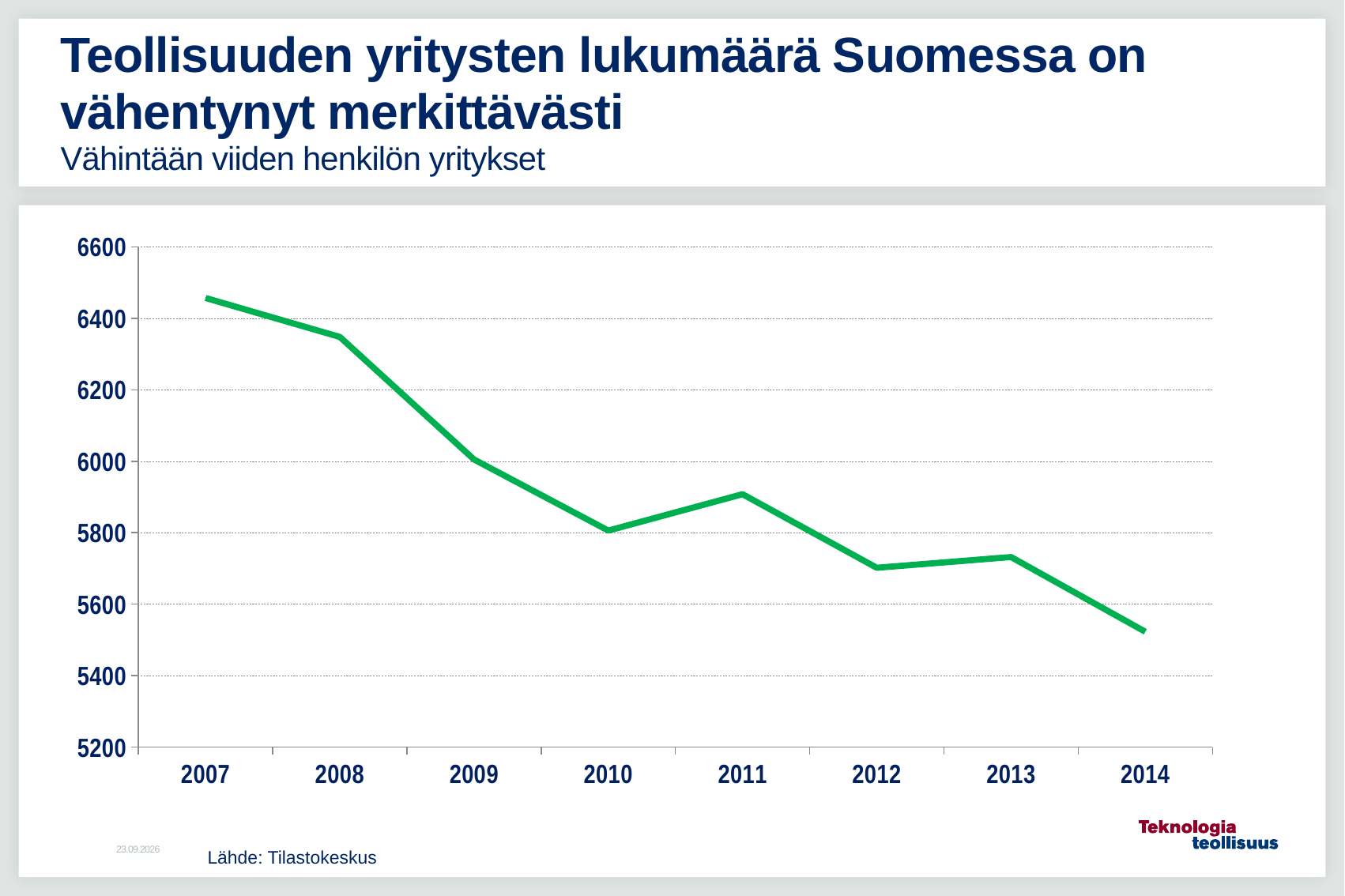
Which year has the highest value? 2007 Which year has the lowest value? 2014 Is the value for 2012 greater or less than 5800? less What source is cited below the chart? Tilastokeskus How many years are plotted on the x axis? 8 Is the value for 2008 greater or less than 6400? less Which is larger, the value for 2010 or the value for 2011? 2011 Do the values generally rise or fall from 2007 to 2014? fall Is the value for 2011 greater or less than 6000? less What kind of chart is shown on the slide? line chart